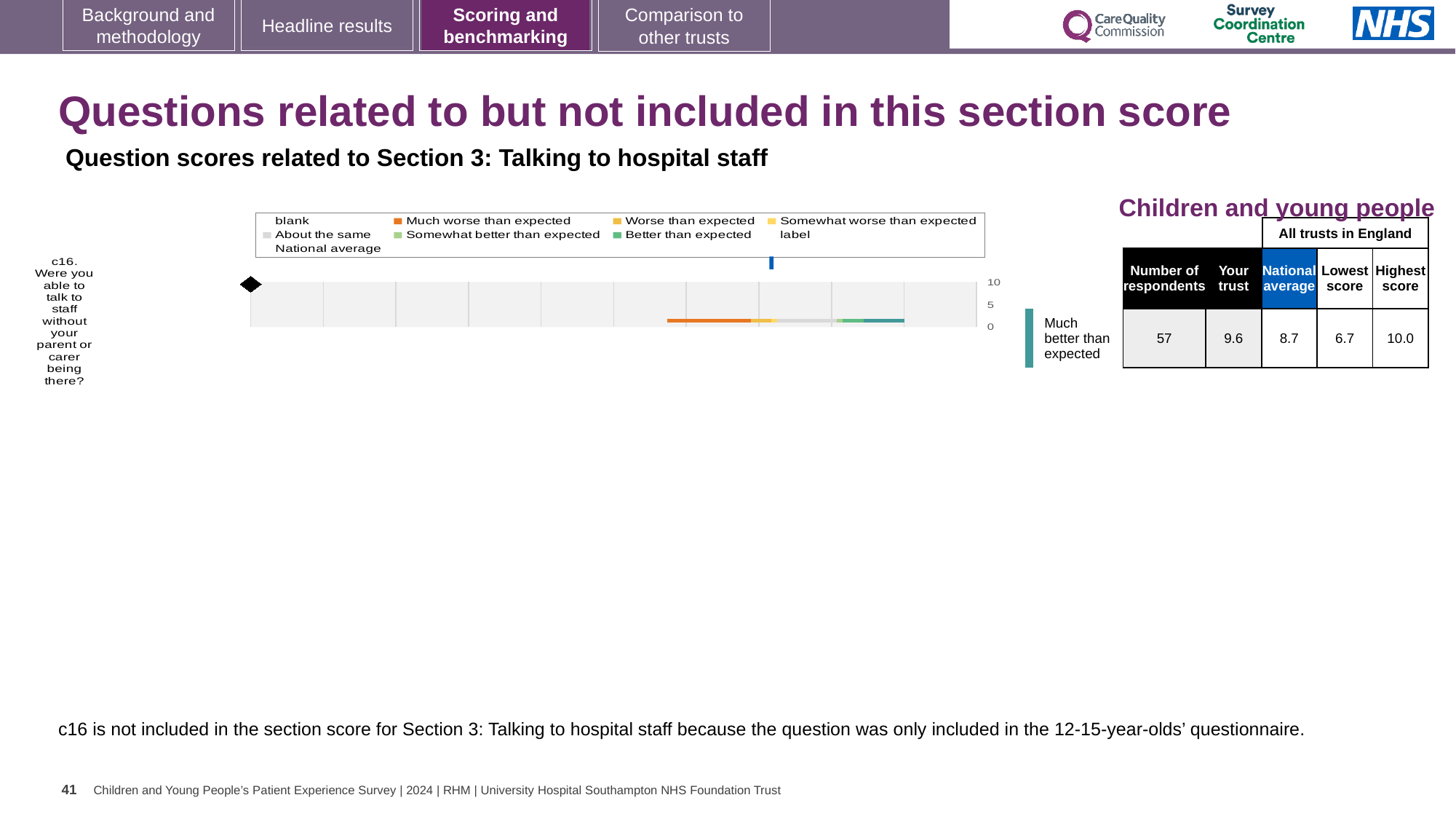
What is the national average score for c16? 8.7 What is the 'Your trust' score for c16? 9.6 What is the highest score among all trusts in England for c16? 10.0 How many entries does the chart legend list? 9 How many respondents answered c16? 57 Which is higher for c16, the trust's score or the national average? Your trust What benchmark label is shown to the right of the c16 bar? Much better than expected What is the difference between the trust's score and the national average for c16? 0.9 How many survey questions are plotted on the chart? 1 What kind of chart is used to show the c16 result? bar chart What is the full wording of question c16 shown on the chart? Were you able to talk to staff without your parent or carer being there? What is the lowest score among all trusts in England for c16? 6.7